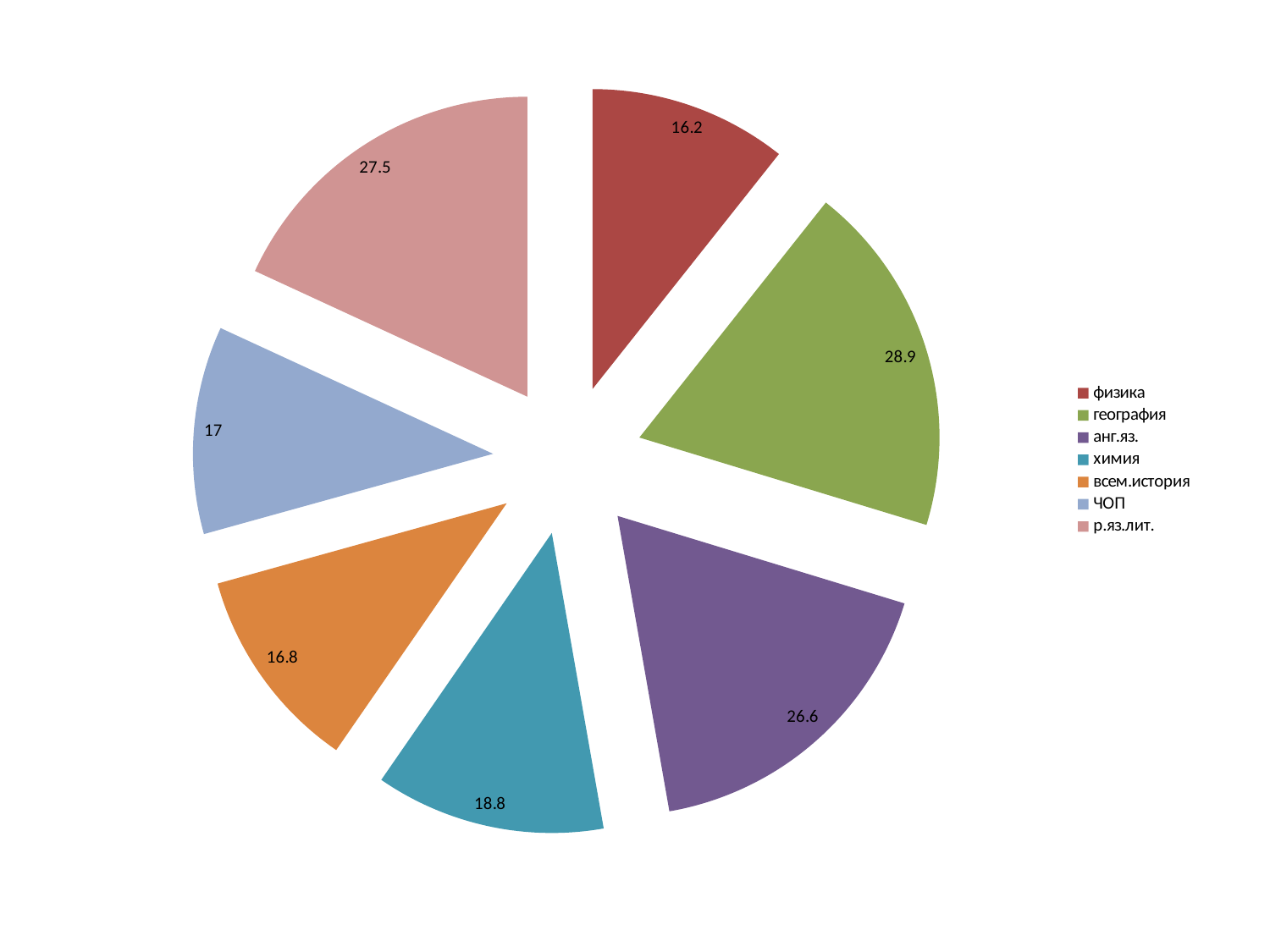
Which category has the smallest slice? физика What is the value shown for физика? 16.2 Which category has the largest slice? география What is the value shown for химия? 18.8 What is the difference between the values for химия and всем.история? 2 How many categories does the pie chart have? 7 What is the value shown for ЧОП? 17 What is the difference between the values for география and физика? 12.7 Which category is shown in orange in the legend? всем.история What type of chart is shown on the slide? pie chart Which is larger, the value for р.яз.лит. or the value for анг.яз.? р.яз.лит. What is the value shown for география? 28.9